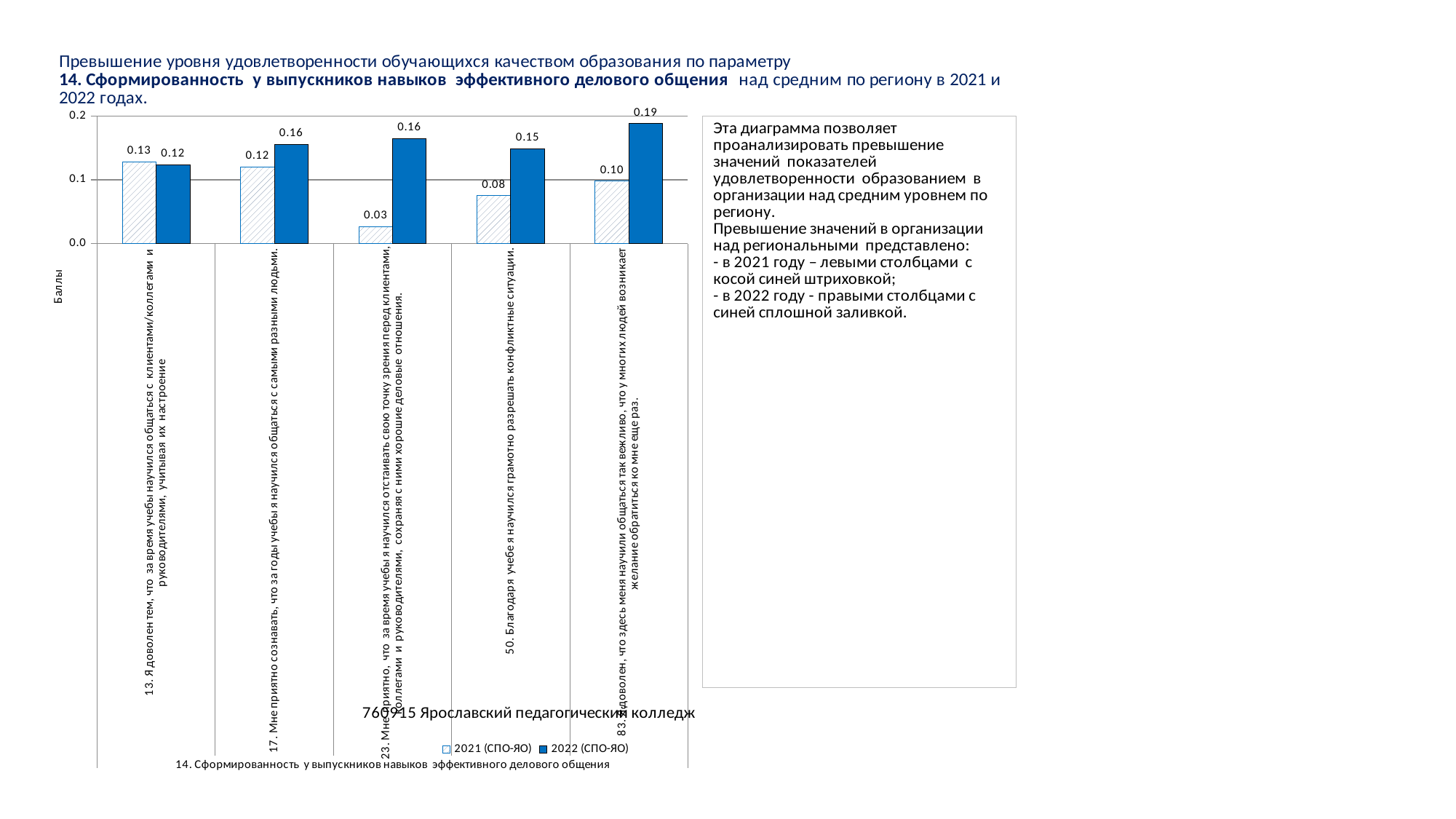
How many statements (categories) are shown on the x axis of the chart? 5 How many series does the chart legend list? 2 What type of chart is shown on the slide? Bar chart What is the value of the 2021 (СПО-ЯО) series for statement 23 ("Мне приятно, что за время учебы я научился отстаивать свою точку зрения перед клиентами...")? 0.03 Is the 2022 (СПО-ЯО) value for statement 50 greater or less than 0.1? greater For statement 13, which series has the larger value, 2021 (СПО-ЯО) or 2022 (СПО-ЯО)? 2021 (СПО-ЯО) What is the value of the 2022 (СПО-ЯО) series for statement 17 ("Мне приятно сознавать, что за годы учебы я научился общаться с самыми разными людьми")? 0.16 What is the value of the 2021 (СПО-ЯО) series for statement 50 ("Благодаря учебе я научился грамотно разрешать конфликтные ситуации")? 0.08 Which statement has the lowest value in the 2021 (СПО-ЯО) series? 23 (Мне приятно, что за время учебы я научился отстаивать свою точку зрения...) Which statement has the highest value in the 2022 (СПО-ЯО) series? 83 (Я доволен, что здесь меня научили общаться так вежливо...) For statement 83, what is the difference between the 2022 (СПО-ЯО) value and the 2021 (СПО-ЯО) value? 0.09 For statement 23, how much higher is the 2022 (СПО-ЯО) value than the 2021 (СПО-ЯО) value? 0.13